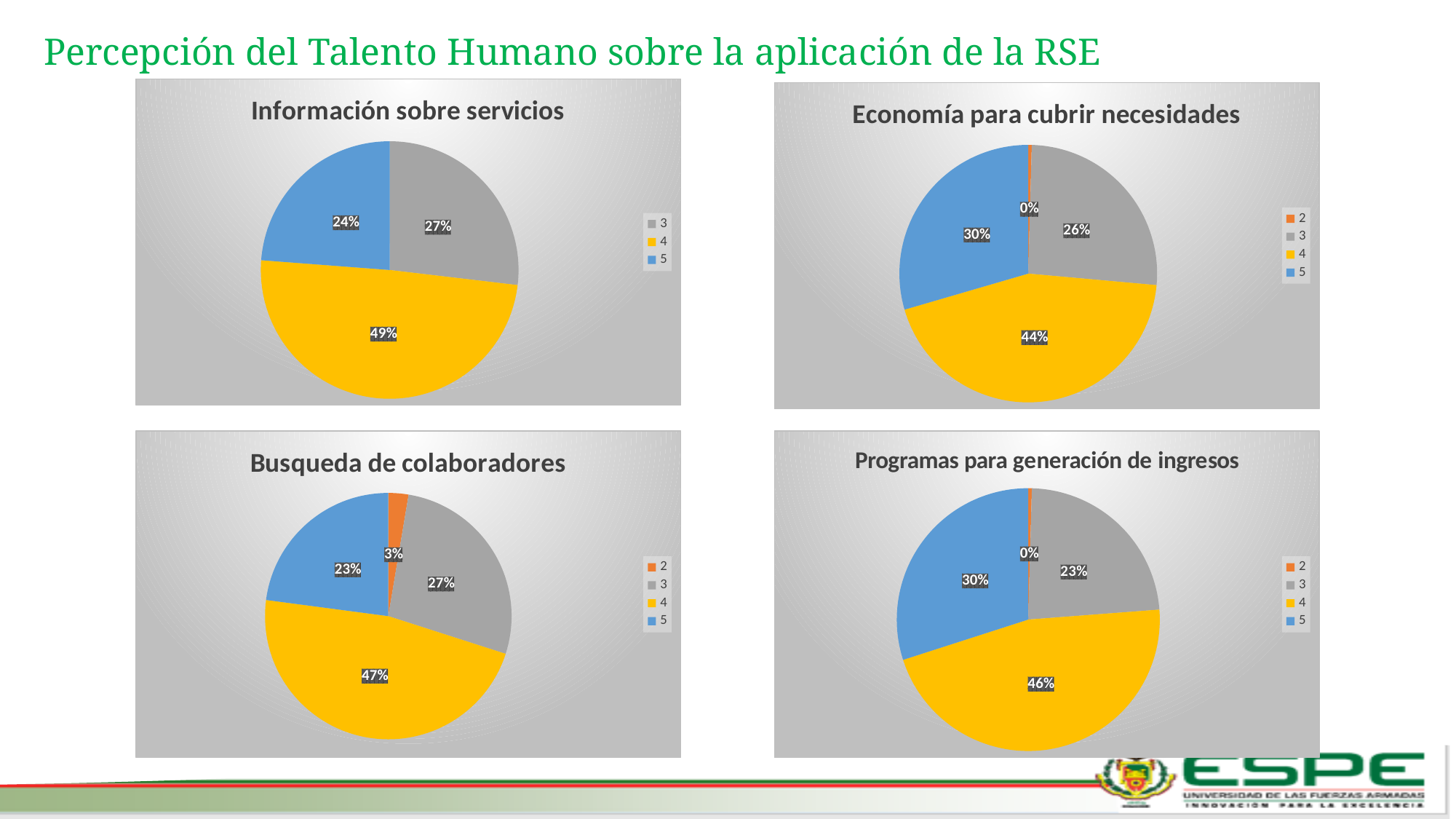
In the 'Información sobre servicios' chart, which category has the smallest share? 5 In the 'Programas para generación de ingresos' chart, what share does category 2 have? 0% In the 'Busqueda de colaboradores' chart, what is the difference between the shares of category 4 and category 3? 20% In the 'Economía para cubrir necesidades' chart, how many entries does the legend list? 4 In the 'Información sobre servicios' chart, how many entries does the legend list? 3 In the 'Economía para cubrir necesidades' chart, which category has the largest share? 4 In the 'Programas para generación de ingresos' chart, what share does category 3 have? 23% In the 'Economía para cubrir necesidades' chart, what share does category 5 have? 30% What type of chart is 'Información sobre servicios'? Pie chart In the 'Busqueda de colaboradores' chart, which is larger, the share of category 3 or category 5? 3 In the 'Busqueda de colaboradores' chart, what share does category 2 have? 3% In the 'Información sobre servicios' chart, what share does category 4 have? 49%